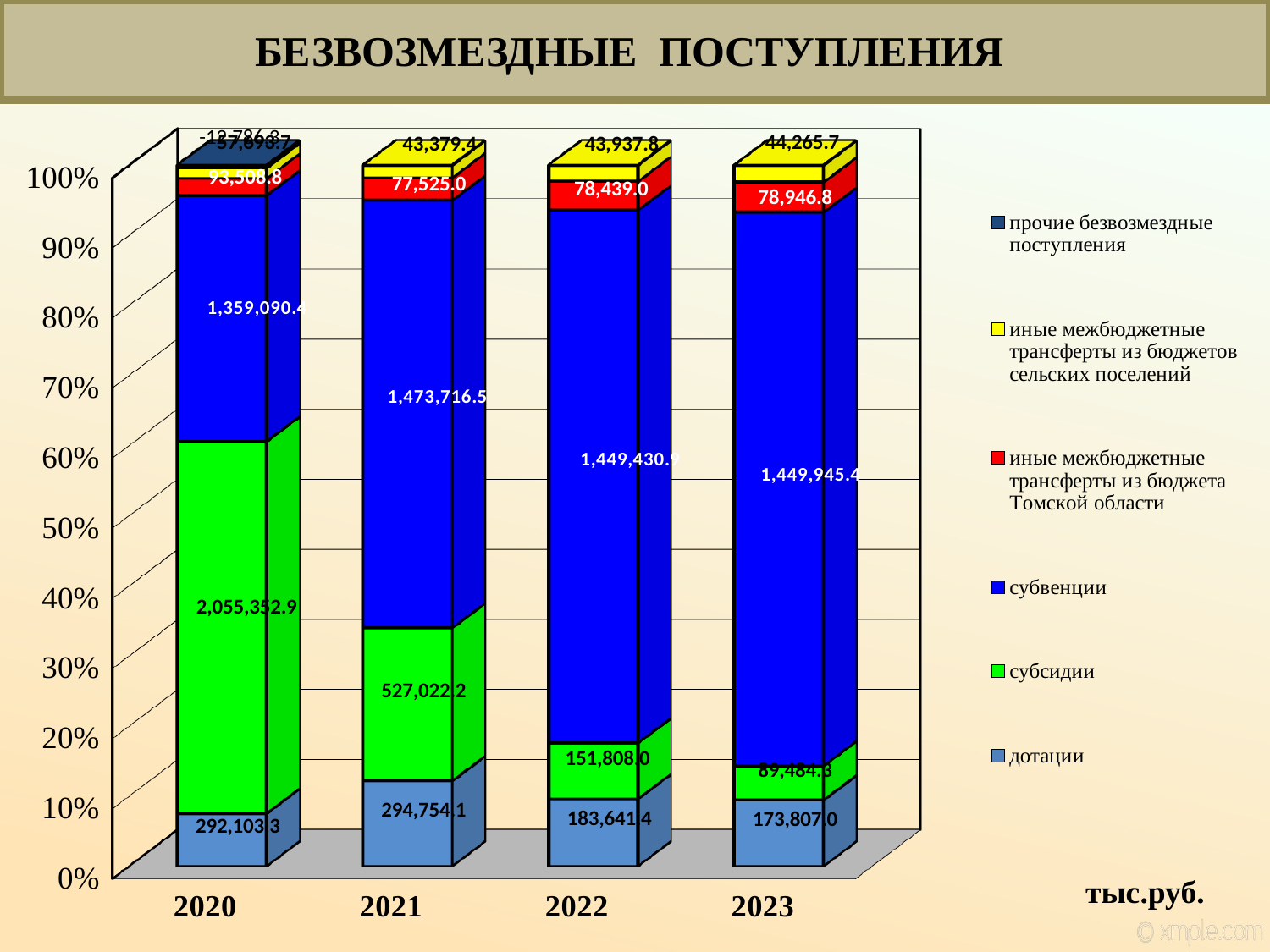
What is the value of дотации for 2023? 173,807.0 How many series does the legend list? 6 Do the субсидии values rise or fall from 2020 to 2023? Fall What is the value of иные межбюджетные трансферты из бюджетов сельских поселений for 2022? 43,937.8 Which is larger: дотации in 2021 or дотации in 2022? 2021 (294,754.1) How many years are shown on the x axis? 4 What is the value of субсидии for 2020? 2,055,352.9 What kind of chart is shown on the slide? Stacked bar chart What is the value of иные межбюджетные трансферты из бюджета Томской области for 2023? 78,946.8 What is the difference between the субсидии values for 2021 and 2022? 375,214.2 In which year is the value of субвенции the highest? 2021 What is the value of субвенции for 2021? 1,473,716.5